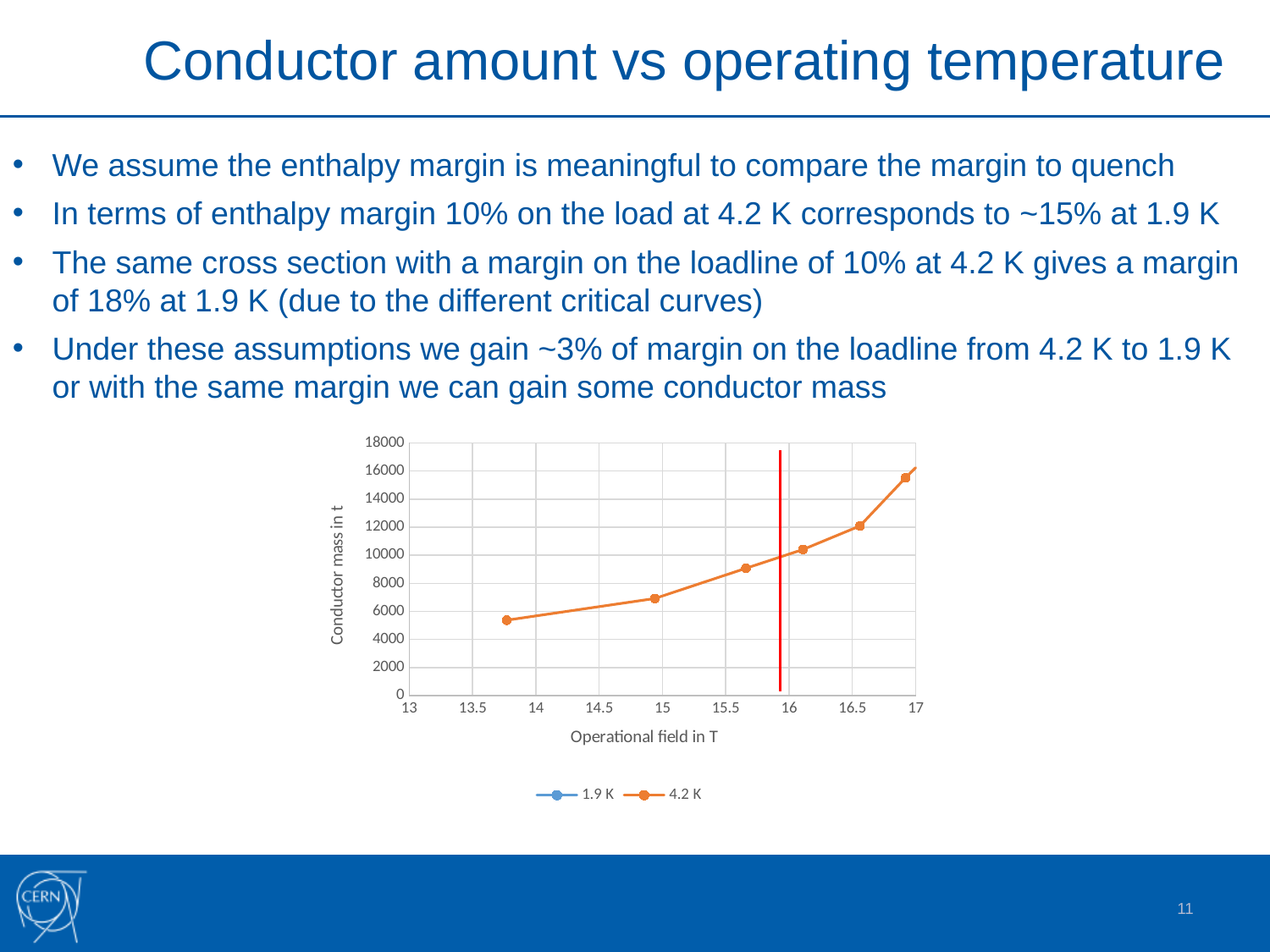
How many data points are plotted on the visible 4.2 K line? 6 Which plotted point has the highest conductor mass, the leftmost or the rightmost? the rightmost Is the conductor mass of the plotted point between 15.5 T and 16 T greater or less than 8000? greater What kind of chart is shown on the slide? line chart How many series does the chart legend list? 2 Is the conductor mass of the rightmost plotted point greater or less than 14000? greater Does the conductor mass rise or fall as the operational field increases along the x axis? rise What are the two series named in the chart legend? 1.9 K and 4.2 K Which plotted point has the lowest conductor mass, the leftmost or the rightmost? the leftmost Is the conductor mass of the plotted point just below 15 T greater or less than 6000? greater What is the label of the y axis of the chart? Conductor mass in t